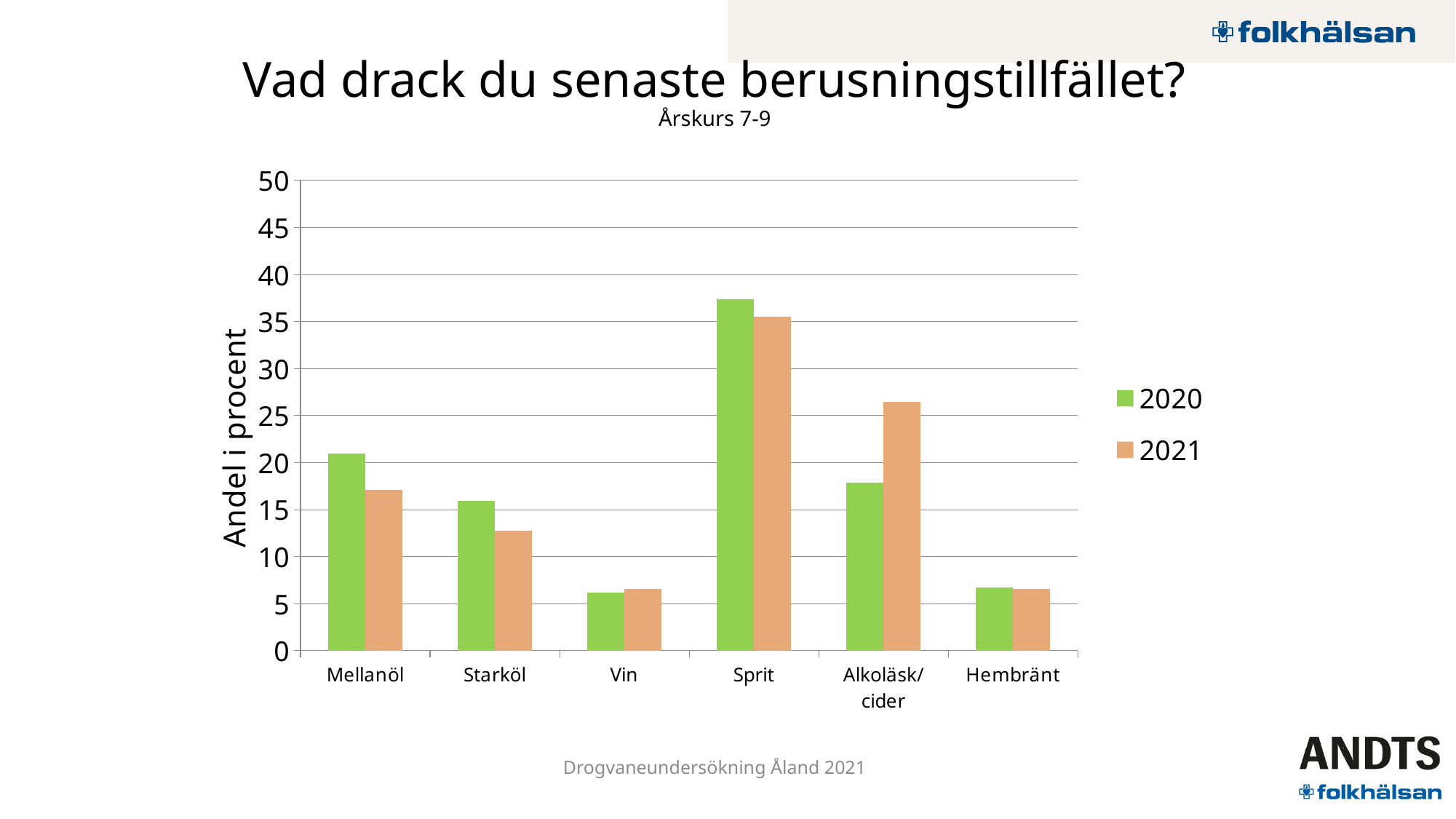
What kind of chart is shown on the slide? bar chart Is the 2021 value for Starköl greater or less than 15? less Is the 2020 value for Sprit greater or less than 35? greater Is the 2021 value for Hembränt greater or less than 10? less How many categories are shown on the x axis? 6 Which category has the highest value for 2021? Sprit For Alkoläsk/cider, which year has the larger value, 2020 or 2021? 2021 For Mellanöl, which year has the larger value, 2020 or 2021? 2020 Which category has the highest value for 2020? Sprit How many series does the legend list? 2